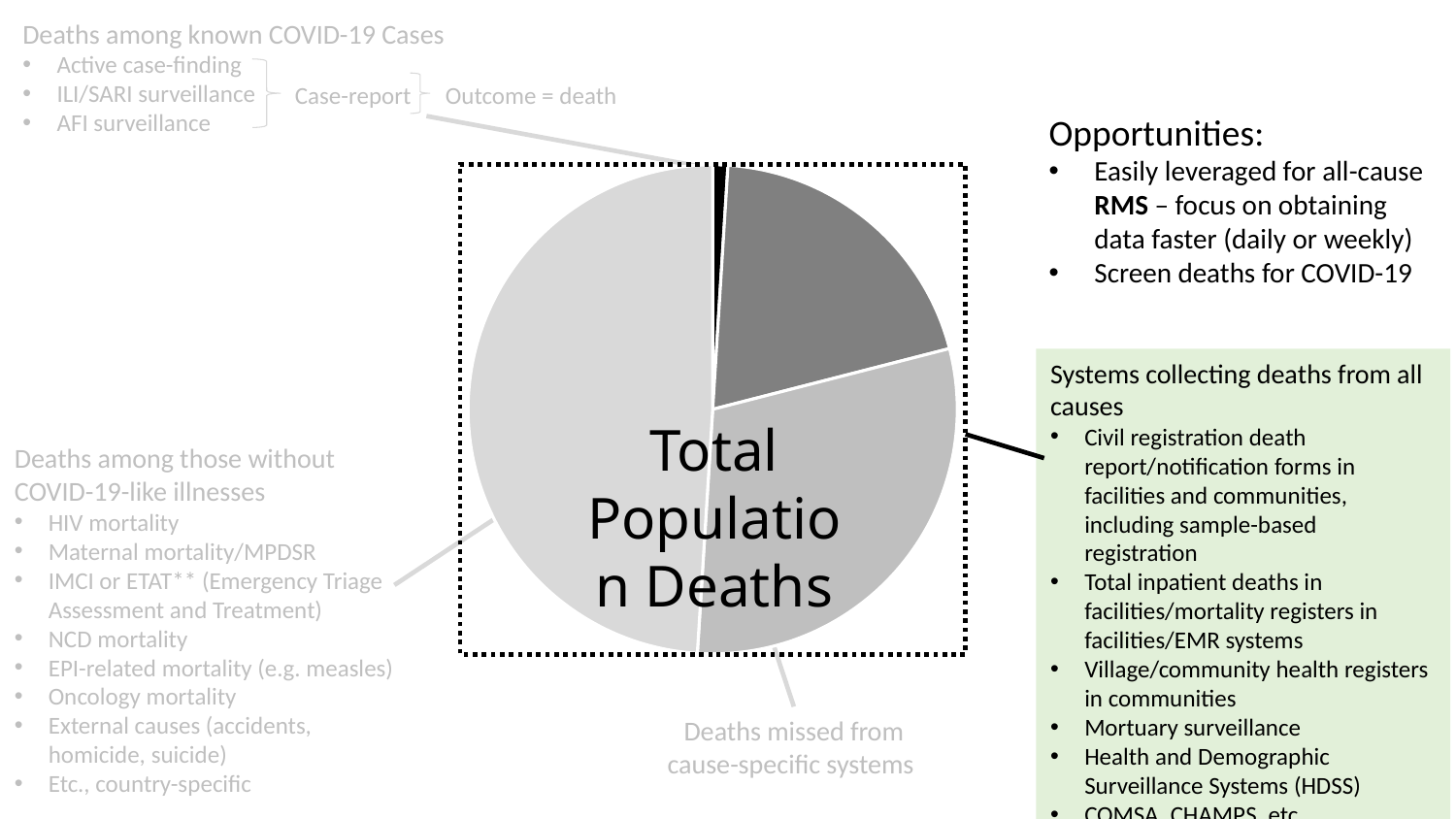
What kind of chart is shown on the slide? pie chart Does the pie chart display a legend? No Which is larger in the pie chart, the dark gray slice or the medium gray slice? the medium gray slice Which slice of the pie chart is the smallest? the thin black slice Which slice of the pie chart is the largest? the light gray slice How many slices does the pie chart have? 4 Which is larger in the pie chart, the black slice or the dark gray slice? the dark gray slice What title is printed on the pie chart? Total Population Deaths